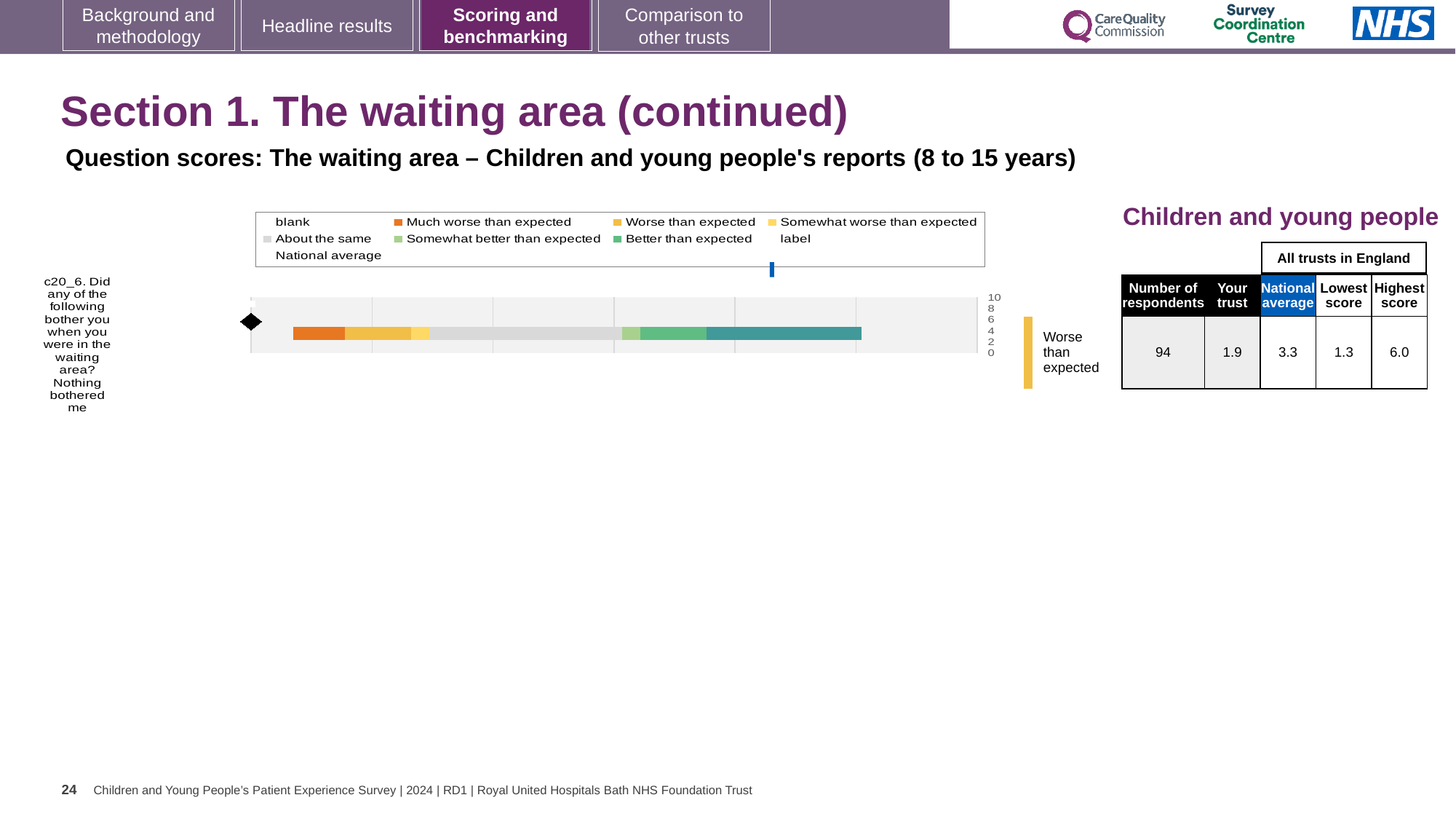
How many question categories are plotted in the bar chart? 1 What is the highest tick value shown on the chart's numeric axis? 10 How many entries does the chart legend list? 9 Which question code is shown as the category label on the bar chart? c20_6 What kind of chart is shown on the slide? Stacked bar chart What is the lowest tick value shown on the chart's numeric axis? 0 What rating text is printed beside the bar chart for this question? Worse than expected What colour does the legend use for 'Much worse than expected'? Orange